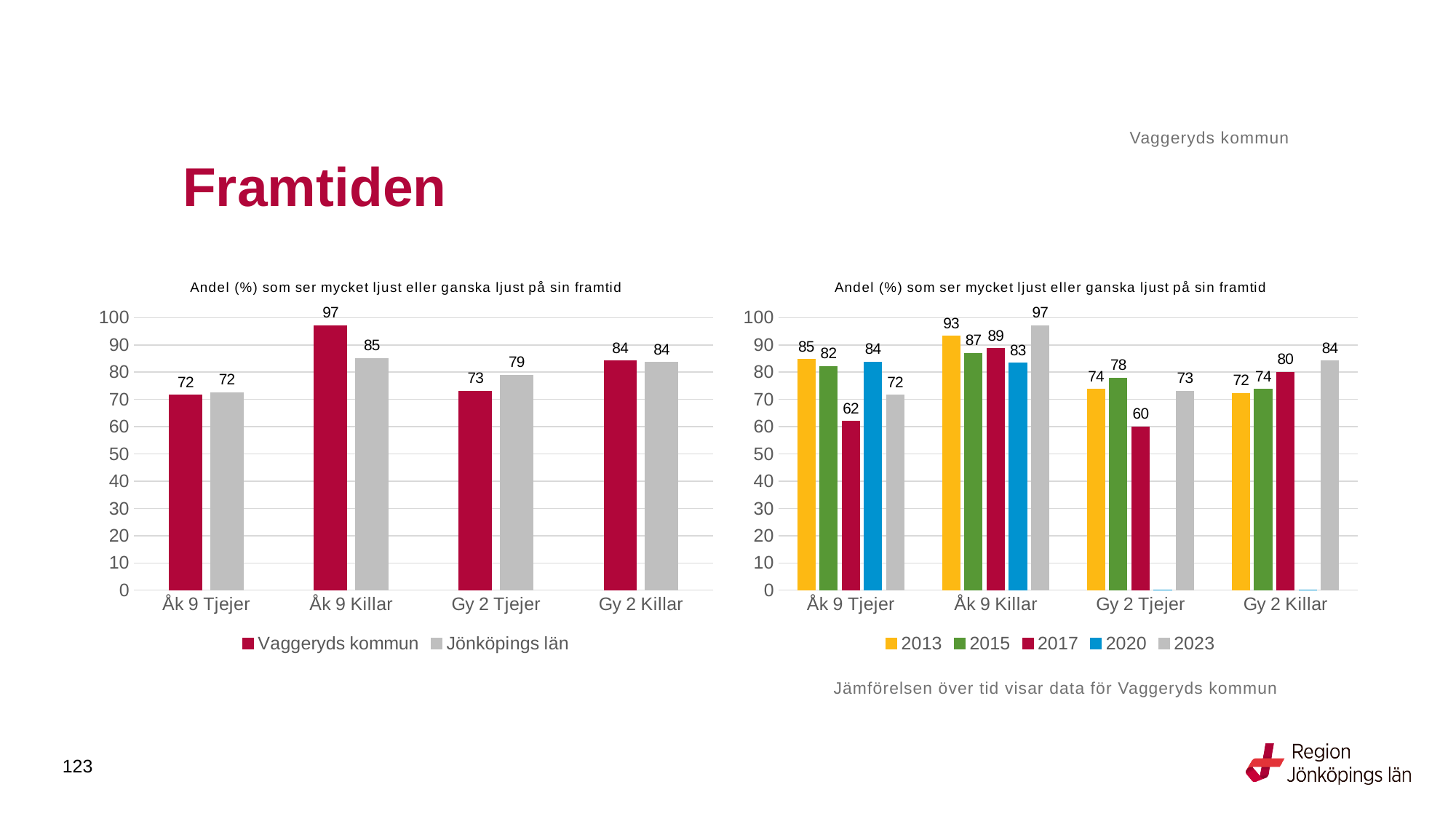
In the left chart, how many series does the legend list? 2 In the left chart, what is the value for Jönköpings län for Gy 2 Tjejer? 79 In the left chart, which category has the highest value for Vaggeryds kommun? Åk 9 Killar What kind of chart is the left chart? Bar chart In the right chart, what is the difference between the 2023 and 2013 values for Gy 2 Killar? 12 In the right chart, what is the value for 2023 for Gy 2 Killar? 84 In the right chart, how many series does the legend list? 5 In the left chart, what is the difference between Vaggeryds kommun and Jönköpings län for Åk 9 Killar? 12 In the right chart, which year has the lowest value for Gy 2 Tjejer? 2017 In the right chart, which is larger for Åk 9 Killar: the value for 2013 or the value for 2023? 2023 In the right chart, what is the value for 2017 for Åk 9 Tjejer? 62 In the left chart, what is the value for Vaggeryds kommun for Åk 9 Killar? 97